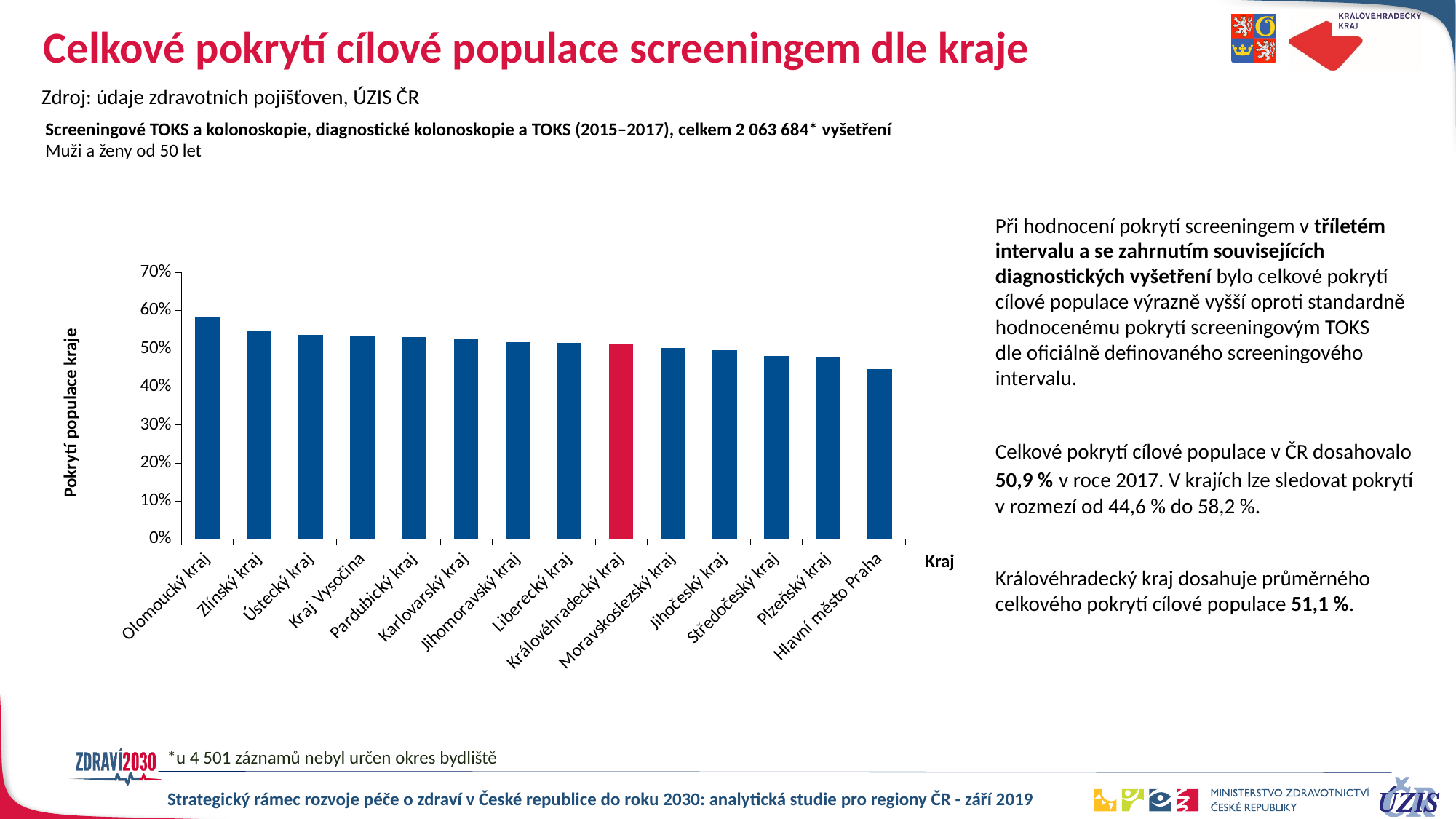
Is the value for Plzeňský kraj greater or less than 50%? less Do the bar values rise or fall from left to right along the x axis? fall Is the value for Hlavní město Praha greater or less than 50%? less Which region has the highest coverage in the chart? Olomoucký kraj What kind of chart is shown on the slide? bar chart Which region has the lowest coverage in the chart? Hlavní město Praha Is the value for Olomoucký kraj greater or less than 50%? greater Which has the larger value, Ústecký kraj or Středočeský kraj? Ústecký kraj Which has the larger value, Olomoucký kraj or Hlavní město Praha? Olomoucký kraj How many regions (kraje) are plotted on the x axis of the chart? 14 Which region's bar is highlighted in red in the chart? Královéhradecký kraj